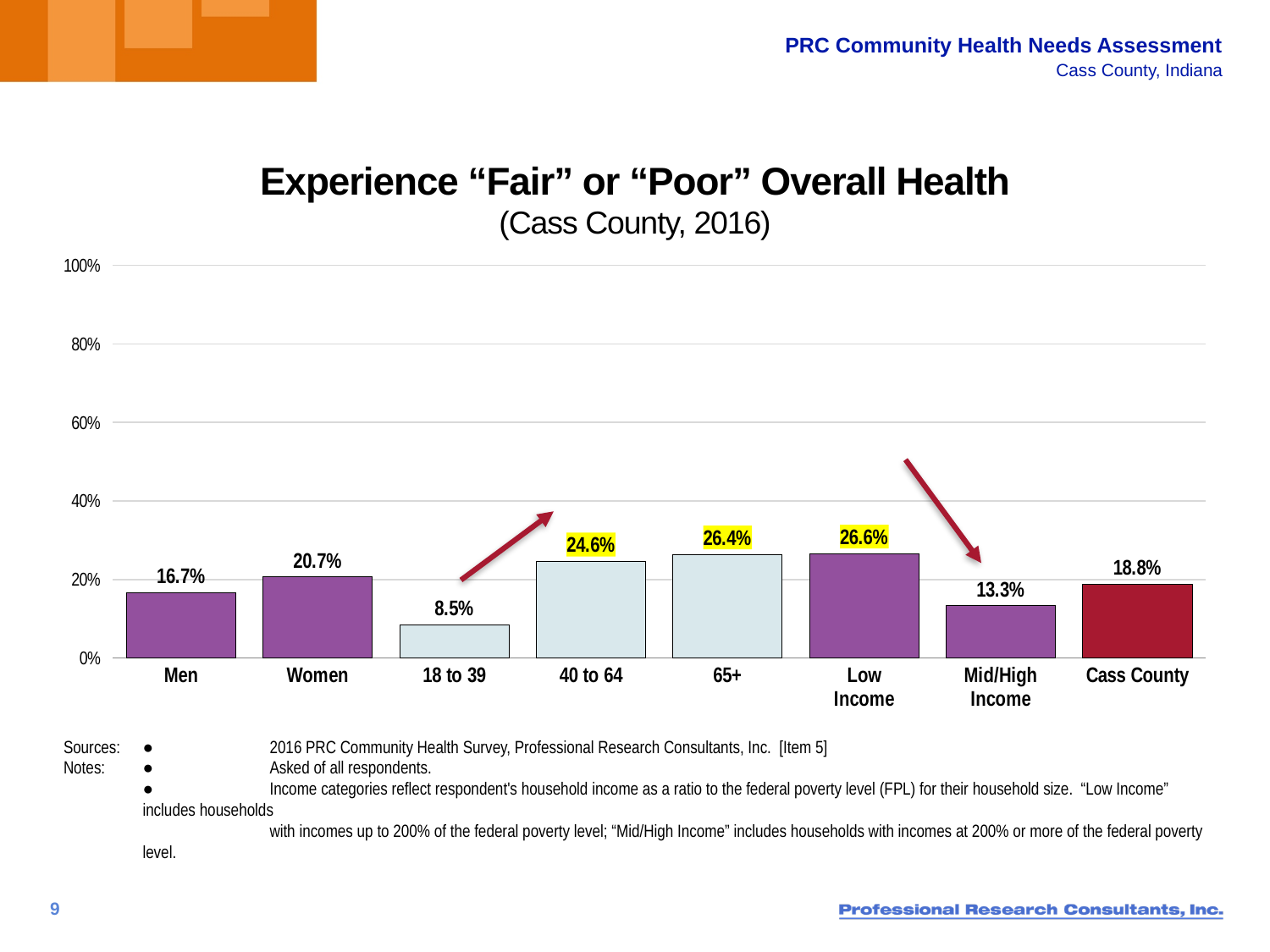
What is the value for the 18 to 39 age group? 8.5% What is the value for Cass County overall? 18.8% What kind of chart is this? bar chart What is the value for Women? 20.7% Which category has the lowest value? 18 to 39 What is the difference between the Women and Men values? 4.0% Which is larger, the value for 40 to 64 or the value for 65+? 65+ Which category has the highest value? Low Income Do the values rise or fall across the three age groups from 18 to 39 to 65+? rise What is the difference between the Low Income and Mid/High Income values? 13.3% Is the value for Mid/High Income greater or less than 20%? less How many categories are shown on the x axis? 8